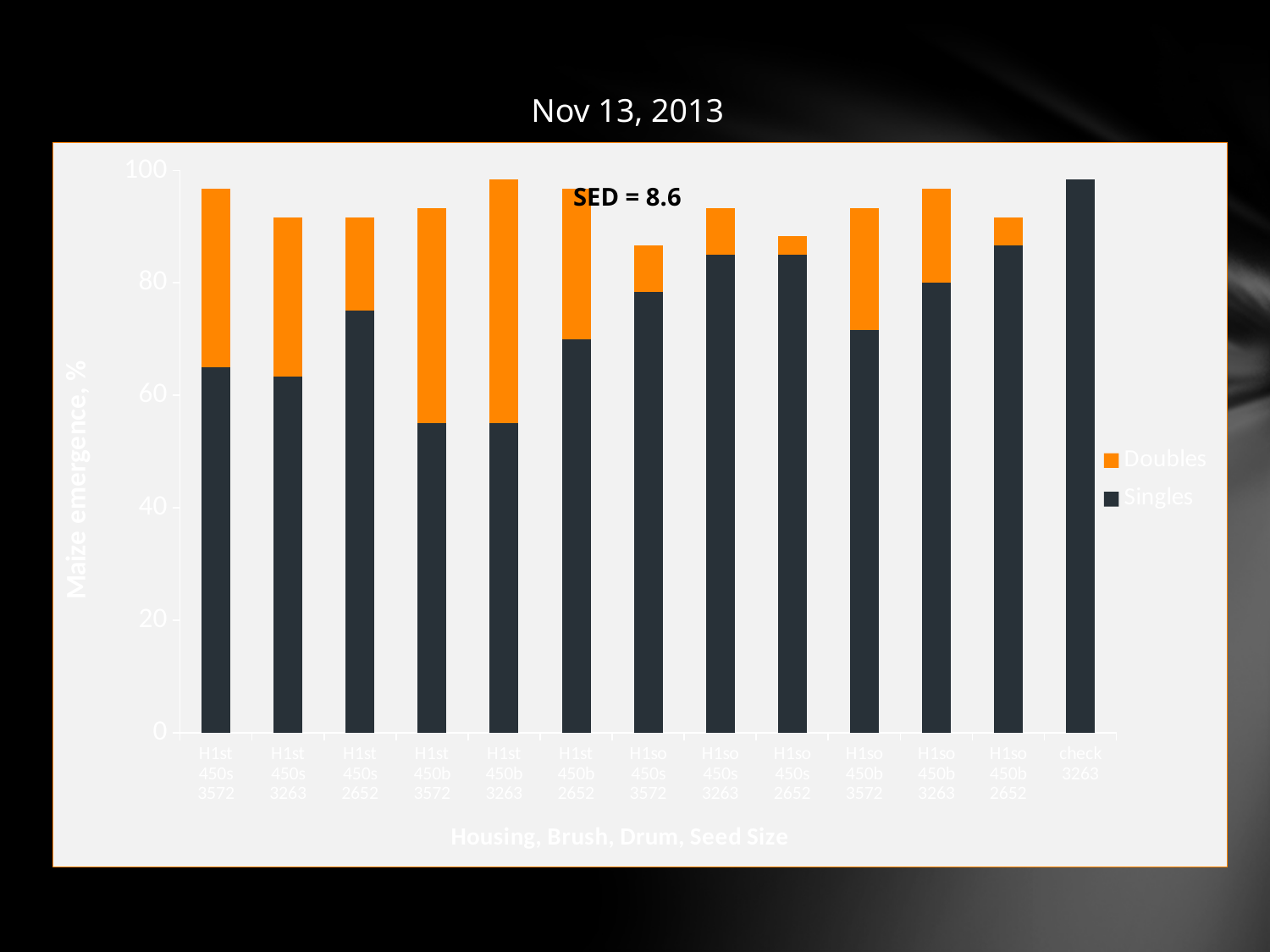
What kind of chart is shown on the slide? Stacked bar chart Which has the larger Doubles value, H1st 450b 3572 or H1so 450s 3263? H1st 450b 3572 Is the Singles value for H1so 450b 2652 greater or less than 80? greater Is the Singles value for check 3263 greater or less than 80? greater Which has the larger Singles value, H1st 450s 2652 or H1st 450s 3263? H1st 450s 2652 How many categories are plotted along the x axis? 13 Is the total stacked value for H1so 450s 3572 greater or less than 90? less Which category has the highest Singles value? check 3263 What is the title of the chart? Nov 13, 2013 How many series does the legend list? 2 What are the two series named in the legend? Doubles and Singles